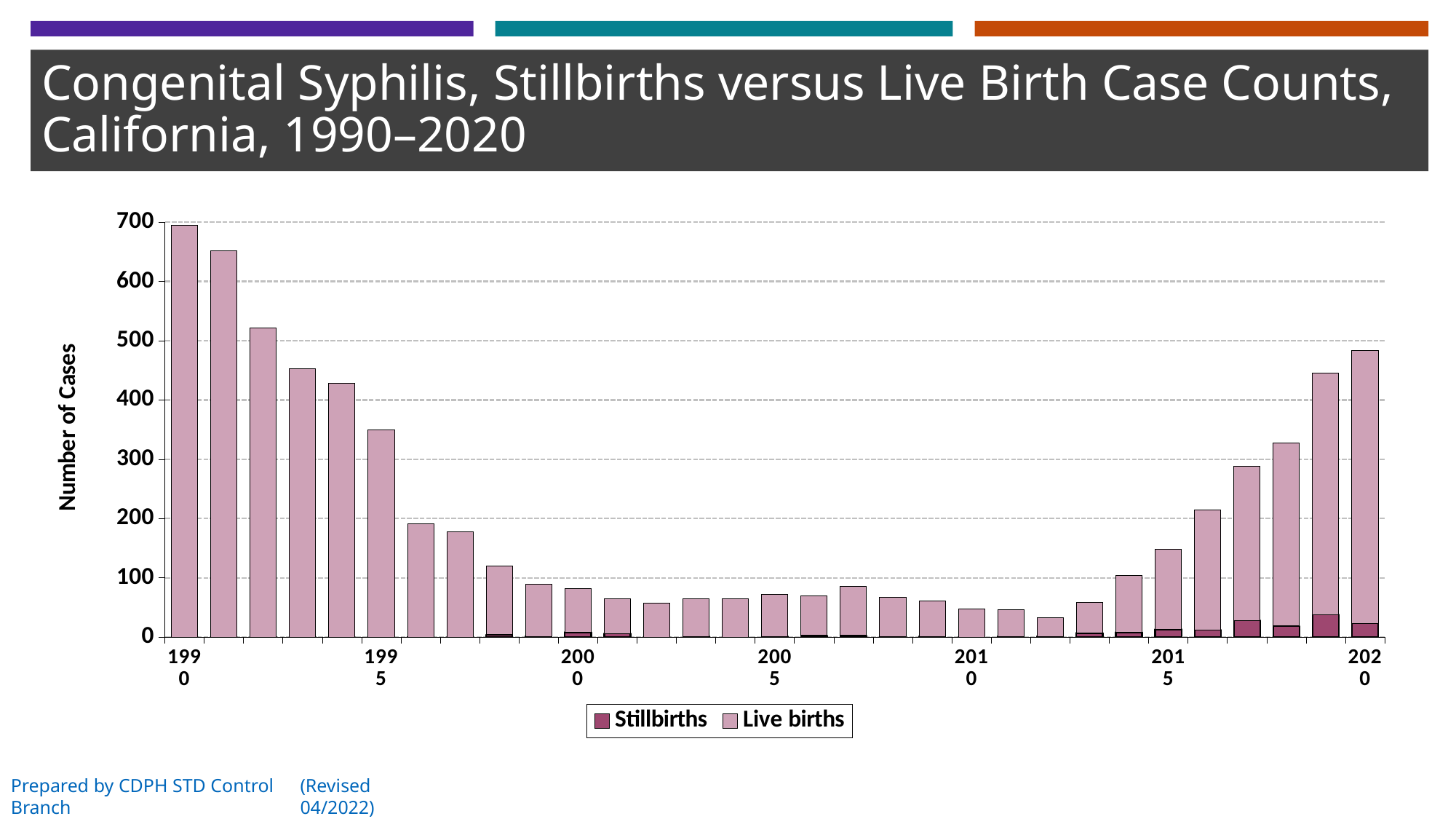
Which year has more total cases, 1995 or 2020? 2020 Do the total case counts rise or fall from 1990 to 2000? fall How many series does the legend list? 2 How many years (bars) are plotted on the chart? 31 What is the label on the vertical axis? Number of Cases Is the total number of cases for 2010 greater or less than 100? less Is the total number of cases for 1990 greater or less than 600? greater What are the two series named in the legend? Stillbirths and Live births Do the total case counts rise or fall from 2010 to 2020? rise Which year has the highest total number of cases? 1990 What kind of chart is shown on the slide? Stacked bar chart Is the total number of cases for 2020 greater or less than 400? greater